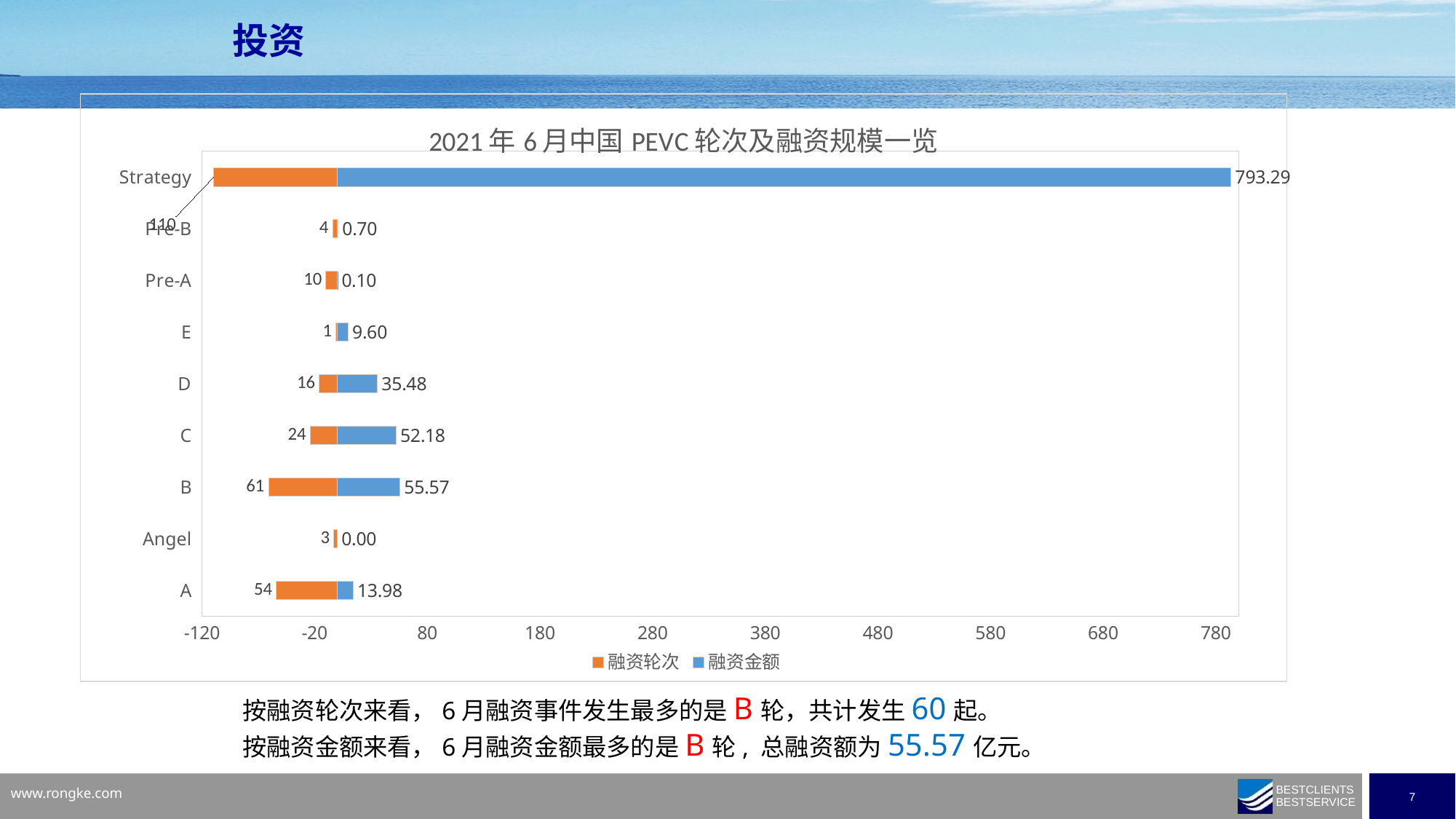
Which category has the lowest 融资金额? Angel What is the 融资轮次 value for Pre-A? 10 What is the difference between the 融资轮次 values for B and A? 7 Which has a larger 融资轮次 value, A or C? A What is the 融资轮次 value for B? 61 What is the difference between the 融资金额 values for B and C? 3.39 What is the 融资金额 value for D? 35.48 How many series does the legend list? 2 How many categories are shown on the chart? 9 What is the 融资金额 value for Strategy? 793.29 Which category has the highest 融资金额? Strategy What kind of chart is shown on the slide? Bar chart